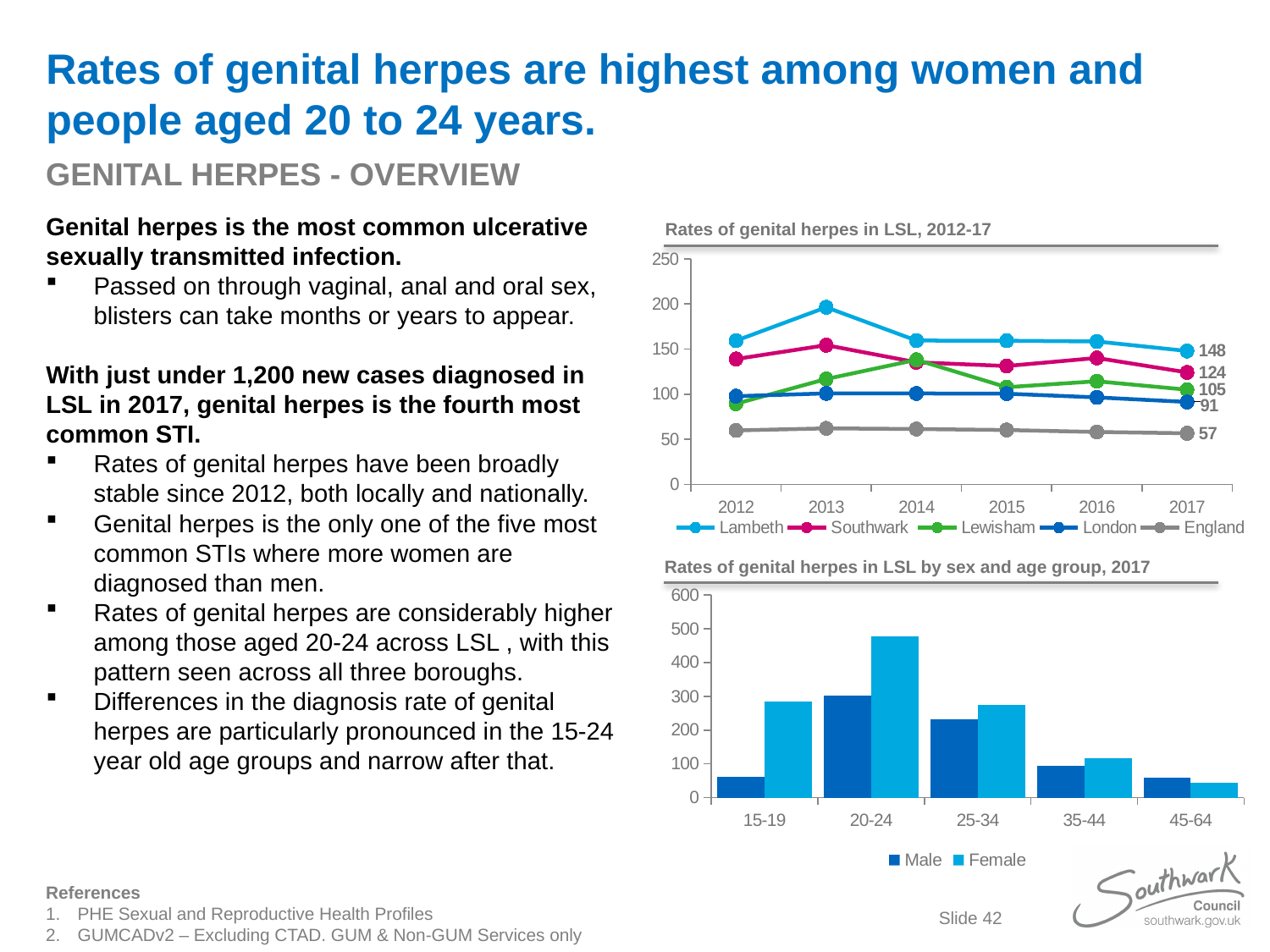
In the chart 'Rates of genital herpes in LSL, 2012-17', what is the value for Lewisham in 2017? 105 How many series does the legend of the chart 'Rates of genital herpes in LSL, 2012-17' list? 5 In the chart 'Rates of genital herpes in LSL by sex and age group, 2017', is the Female value for 20-24 greater or less than 400? greater What kind of chart is 'Rates of genital herpes in LSL, 2012-17'? Line chart In the chart 'Rates of genital herpes in LSL by sex and age group, 2017', which age group has the highest Female value? 20-24 In the chart 'Rates of genital herpes in LSL, 2012-17', which series has the lowest value in 2017? England How many age groups are shown in the chart 'Rates of genital herpes in LSL by sex and age group, 2017'? 5 In the chart 'Rates of genital herpes in LSL by sex and age group, 2017', which is larger for the 20-24 age group, Male or Female? Female In the chart 'Rates of genital herpes in LSL, 2012-17', what is the difference between the 2017 values for Lambeth and Southwark? 24 In the chart 'Rates of genital herpes in LSL, 2012-17', which series has the highest value in 2017? Lambeth In the chart 'Rates of genital herpes in LSL, 2012-17', what is the value for England in 2017? 57 In the chart 'Rates of genital herpes in LSL, 2012-17', what is the value for Lambeth in 2017? 148